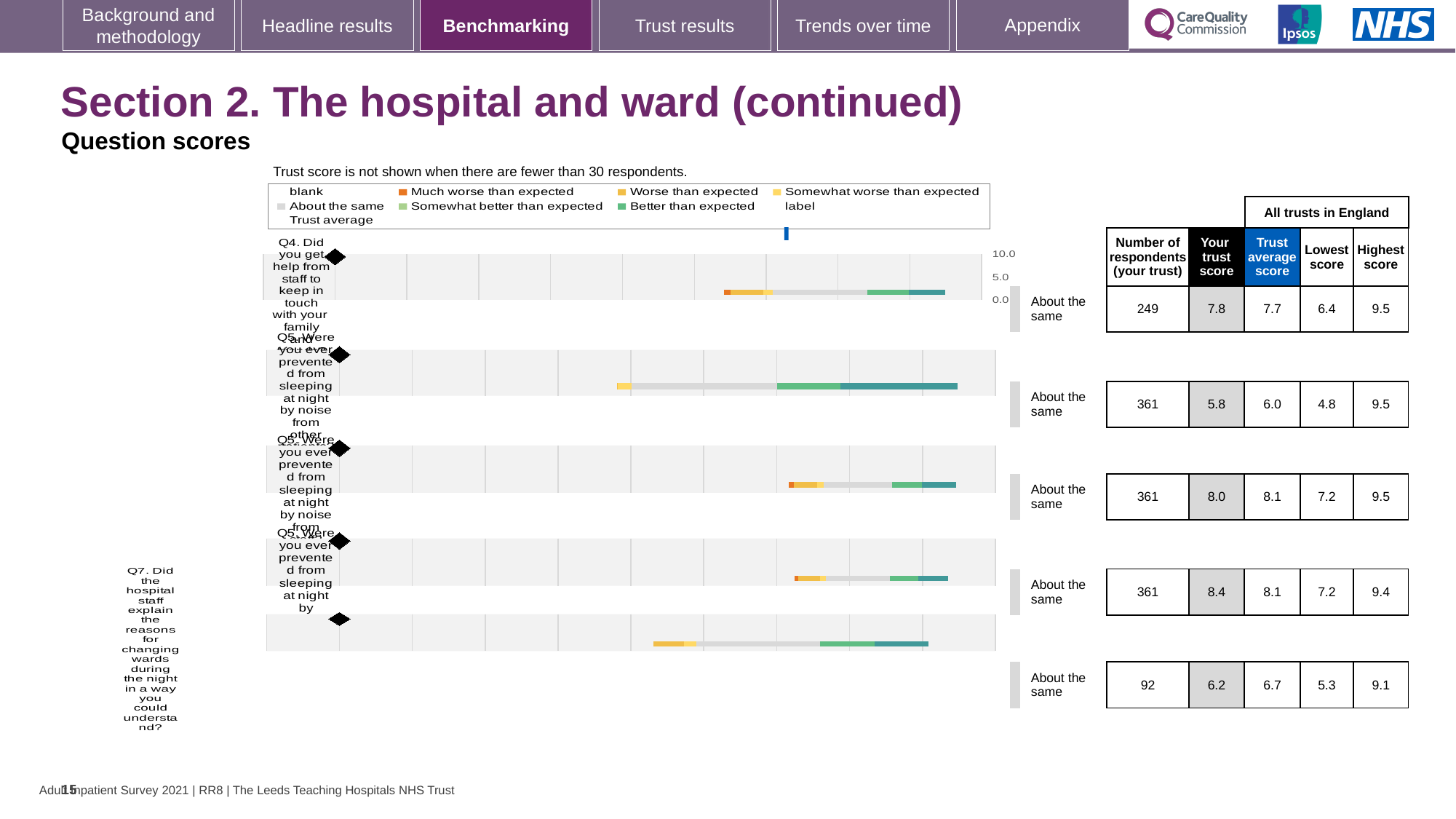
What is the lowest score across all trusts in England for Q7? 5.3 What is the 'Your trust score' for Q4 (help from staff to keep in touch with family and friends)? 7.8 What is the trust average score for Q4? 7.7 What is the 'Your trust score' for Q7 (explaining reasons for changing wards during the night)? 6.2 What kind of chart is used to show the question scores on this slide? bar chart Which question row has the lowest 'Your trust score' in the table? The second row (5.8) What is the difference between the highest score and the lowest score for Q4? 3.1 What benchmark category is shown next to every question row on this slide? About the same How many respondents answered Q7? 92 How many respondents from your trust answered Q4? 249 How many question rows are plotted on the chart? 5 For Q4, which is larger: your trust score or the trust average score? Your trust score